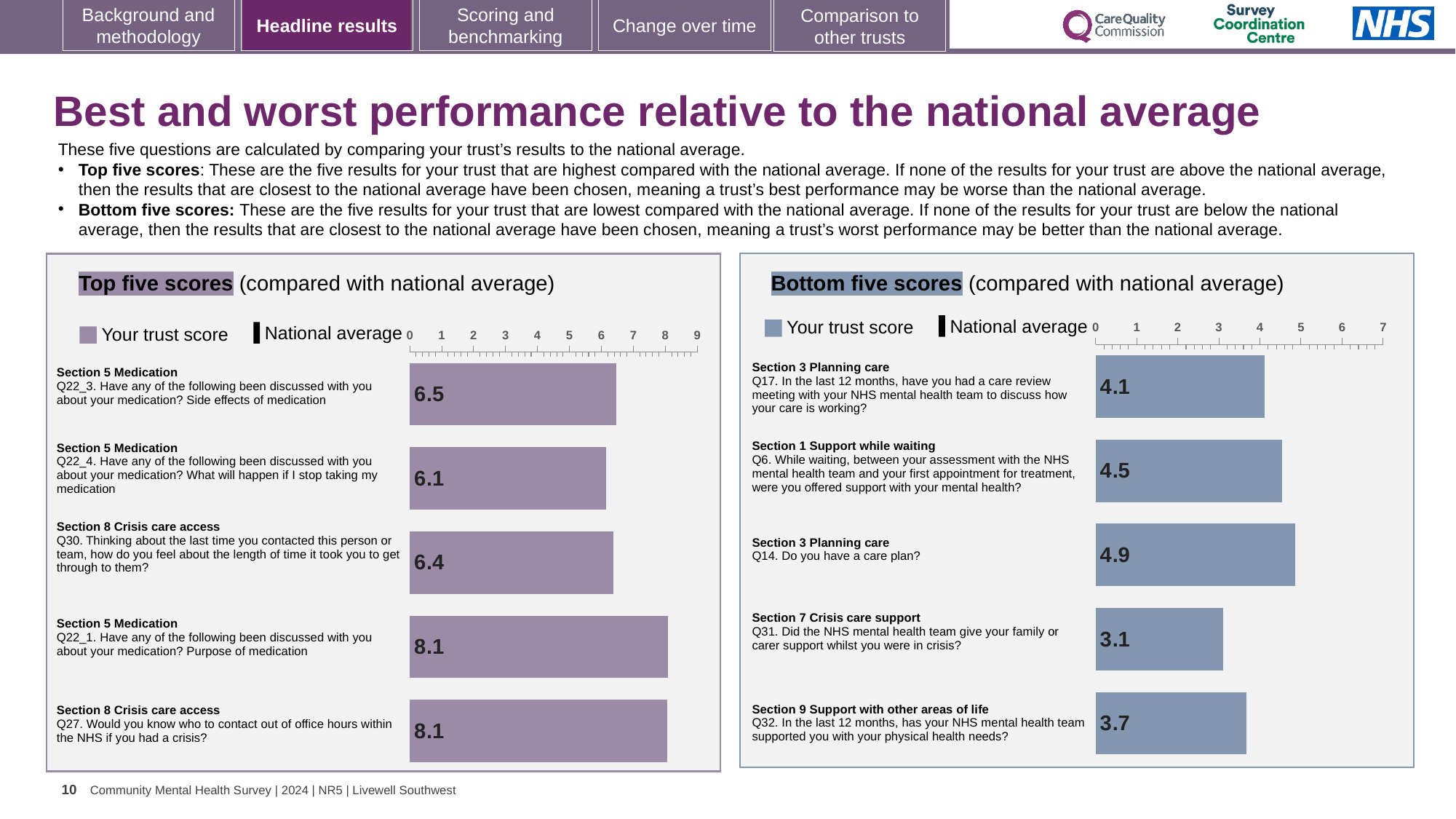
What kind of chart is the Top five scores chart? Bar chart How many questions are shown in the Bottom five scores chart? 5 How many series does the legend of the Top five scores chart list? 2 In the Top five scores chart, what is the difference between the trust scores for Q22_3 and Q22_4? 0.4 In the Bottom five scores chart, what is the trust score for Q31 (Did the NHS mental health team give your family or carer support whilst you were in crisis?)? 3.1 In the Top five scores chart, which has the larger trust score: Q30 or Q22_4? Q30 In the Top five scores chart, which question has the lowest trust score? Q22_4 In the Bottom five scores chart, is the trust score for Q6 greater or less than 4? greater In the Bottom five scores chart, which question has the highest trust score? Q14 In the Top five scores chart, what is the trust score for Q22_3 (Side effects of medication)? 6.5 In the Bottom five scores chart, what is the difference between the trust scores for Q14 and Q31? 1.8 In the Bottom five scores chart, which question has the lowest trust score? Q31